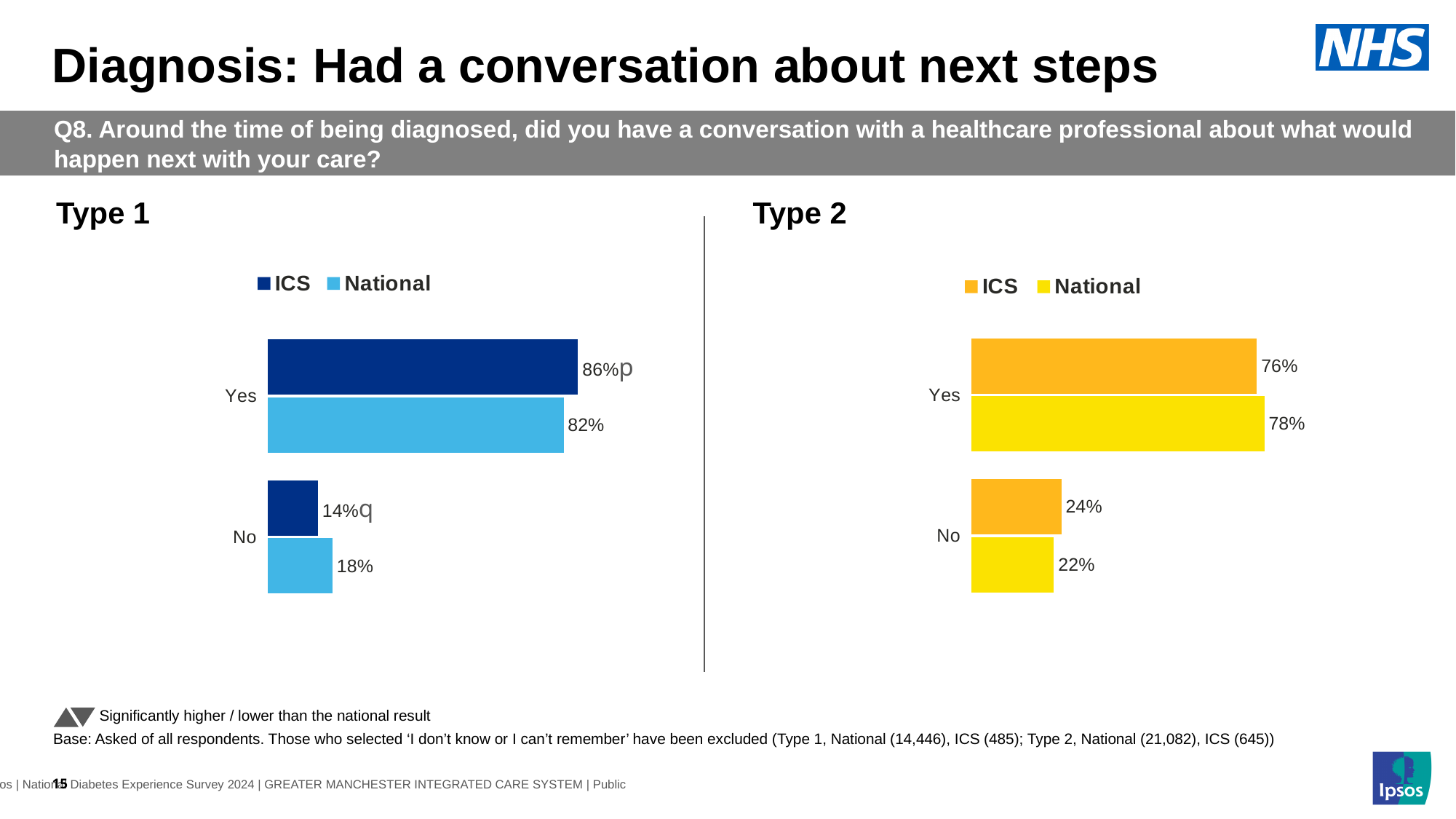
In the Type 2 chart, what is the difference between the ICS and National values for No? 2 percentage points In the Type 1 chart, which is larger for No: ICS or National? National In the Type 2 chart, what is the ICS value for Yes? 76% In the Type 2 chart, what colour are the ICS bars? Orange In the Type 1 chart, what is the ICS value for Yes? 86% How many categories are shown in the Type 2 chart? 2 In the Type 1 chart, what is the difference between the ICS and National values for Yes? 4 percentage points In the Type 2 chart, which is larger for Yes: ICS or National? National How many series does the legend of the Type 1 chart list? 2 In the Type 2 chart, what is the National value for No? 22% In the Type 1 chart, what is the National value for No? 18% What kind of chart is the Type 2 chart? Bar chart